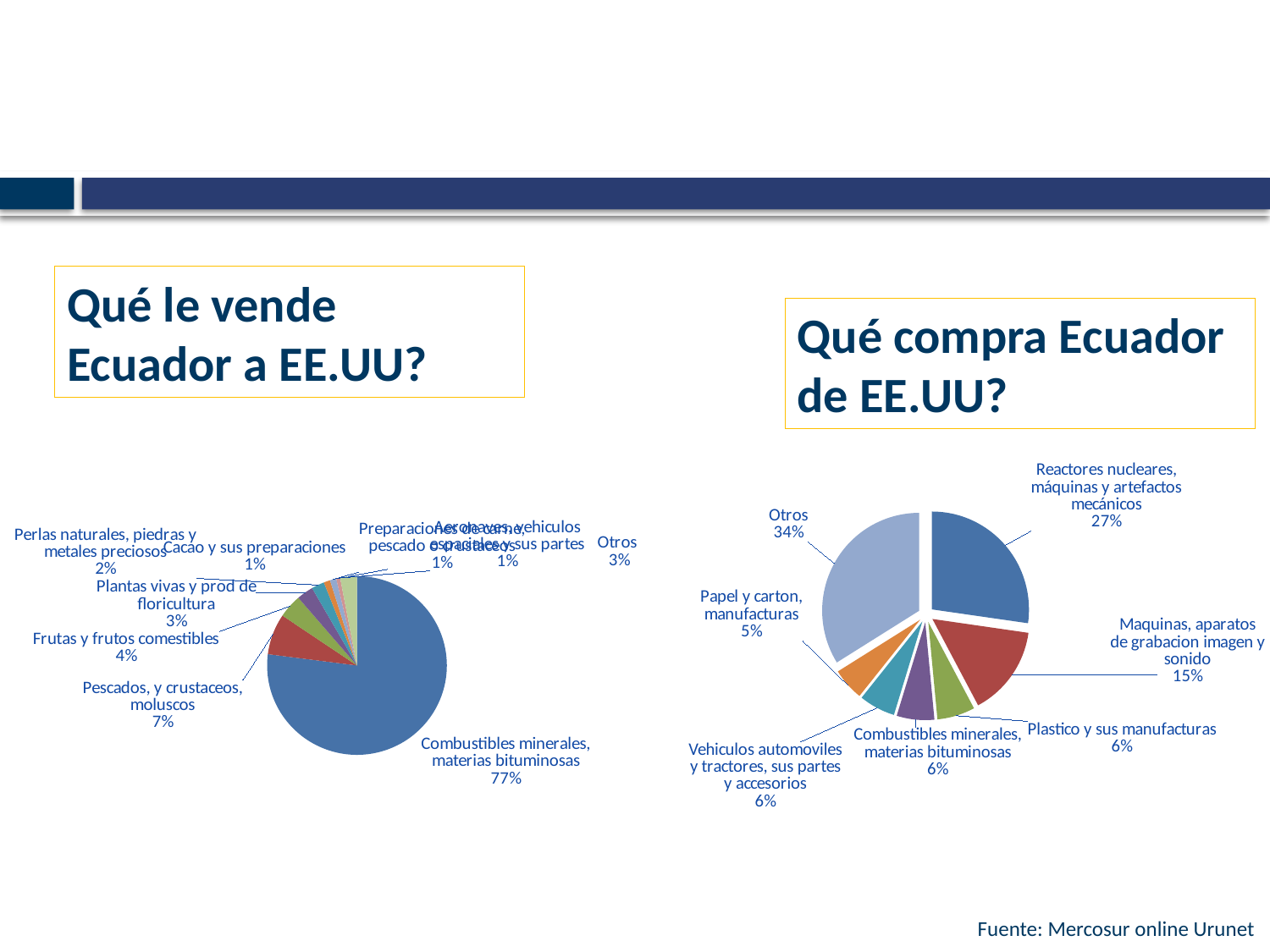
In the chart 'Qué le vende Ecuador a EE.UU?', which category has the largest slice? Combustibles minerales, materias bituminosas In the chart 'Qué compra Ecuador de EE.UU?', what share does 'Papel y carton, manufacturas' have? 5% In the chart 'Qué le vende Ecuador a EE.UU?', what share does 'Pescados, y crustaceos, moluscos' have? 7% In the chart 'Qué compra Ecuador de EE.UU?', what share does 'Maquinas, aparatos de grabacion imagen y sonido' have? 15% How many slices does the chart 'Qué compra Ecuador de EE.UU?' have? 7 In the chart 'Qué le vende Ecuador a EE.UU?', what share does 'Frutas y frutos comestibles' have? 4% In the chart 'Qué compra Ecuador de EE.UU?', what share does 'Reactores nucleares, máquinas y artefactos mecánicos' have? 27% What type of chart is used for 'Qué compra Ecuador de EE.UU?'? Pie chart In the chart 'Qué le vende Ecuador a EE.UU?', what share does 'Combustibles minerales, materias bituminosas' have? 77% In the chart 'Qué compra Ecuador de EE.UU?', which category has the largest slice? Otros In the chart 'Qué compra Ecuador de EE.UU?', which is larger: 'Reactores nucleares, máquinas y artefactos mecánicos' or 'Maquinas, aparatos de grabacion imagen y sonido'? Reactores nucleares, máquinas y artefactos mecánicos In the chart 'Qué le vende Ecuador a EE.UU?', what is the difference between the shares of 'Pescados, y crustaceos, moluscos' and 'Frutas y frutos comestibles'? 3%